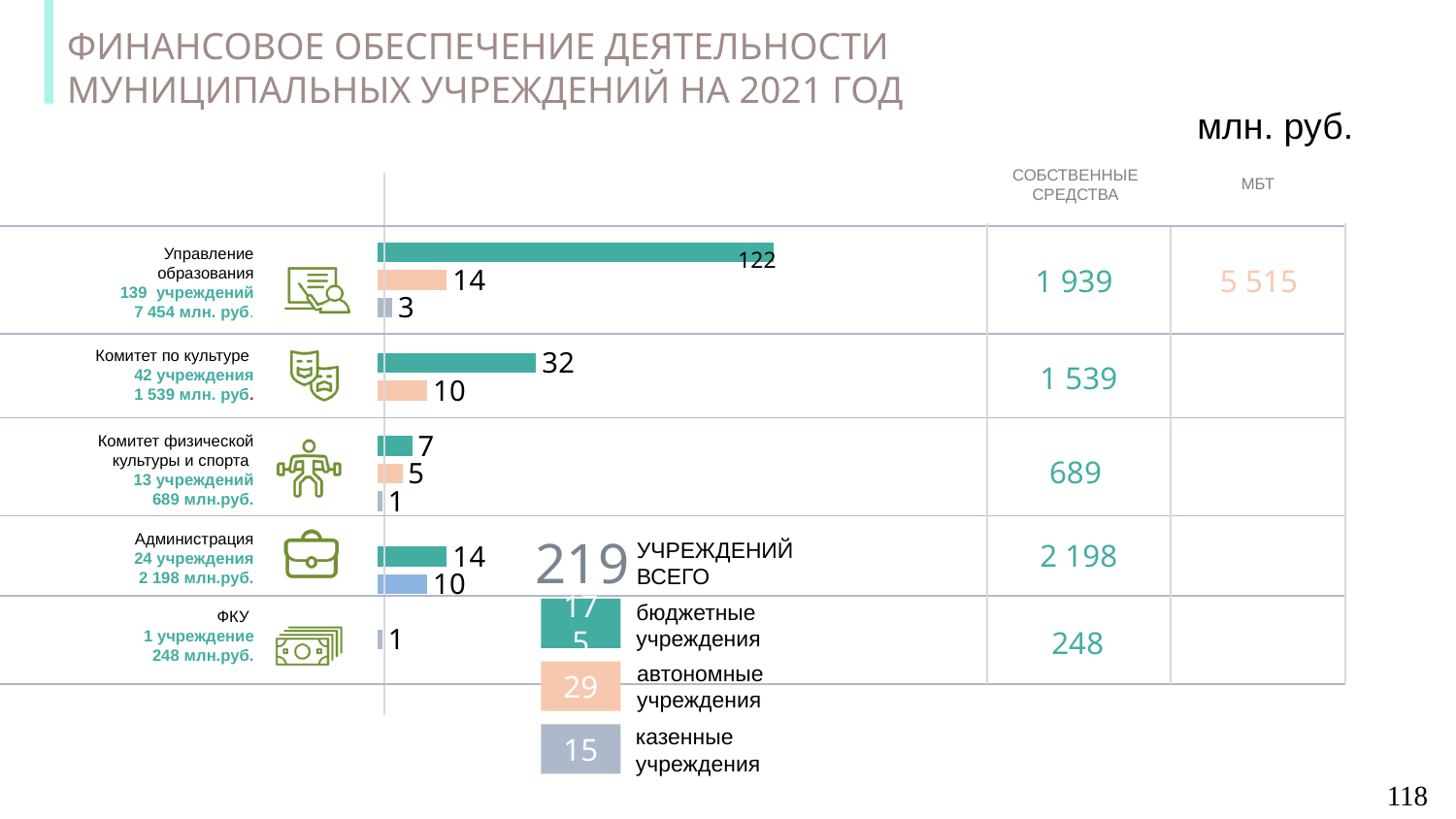
What is the value of собственные средства for Комитет по культуре? 1 539 How many budget institutions (бюджетные учреждения) does Управление образования have according to the chart? 122 What type of chart is used to show the number of institutions by department on the slide? bar chart How many departments (categories) are shown in the bar chart? 5 How many state-owned institutions (казенные учреждения) does Комитет физической культуры и спорта have according to the chart? 1 What is the difference between the number of budget institutions and autonomous institutions for Управление образования? 108 How many institution types does the chart legend list? 3 How many autonomous institutions (автономные учреждения) does Комитет по культуре have according to the chart? 10 What is the МБТ value shown for Управление образования? 5 515 Which is larger for Администрация: the number of budget institutions or the number of state-owned institutions? budget institutions (14) What is the total number of institutions (учреждений всего) shown on the slide? 219 Which department has the highest number of budget institutions (бюджетные учреждения) in the chart? Управление образования